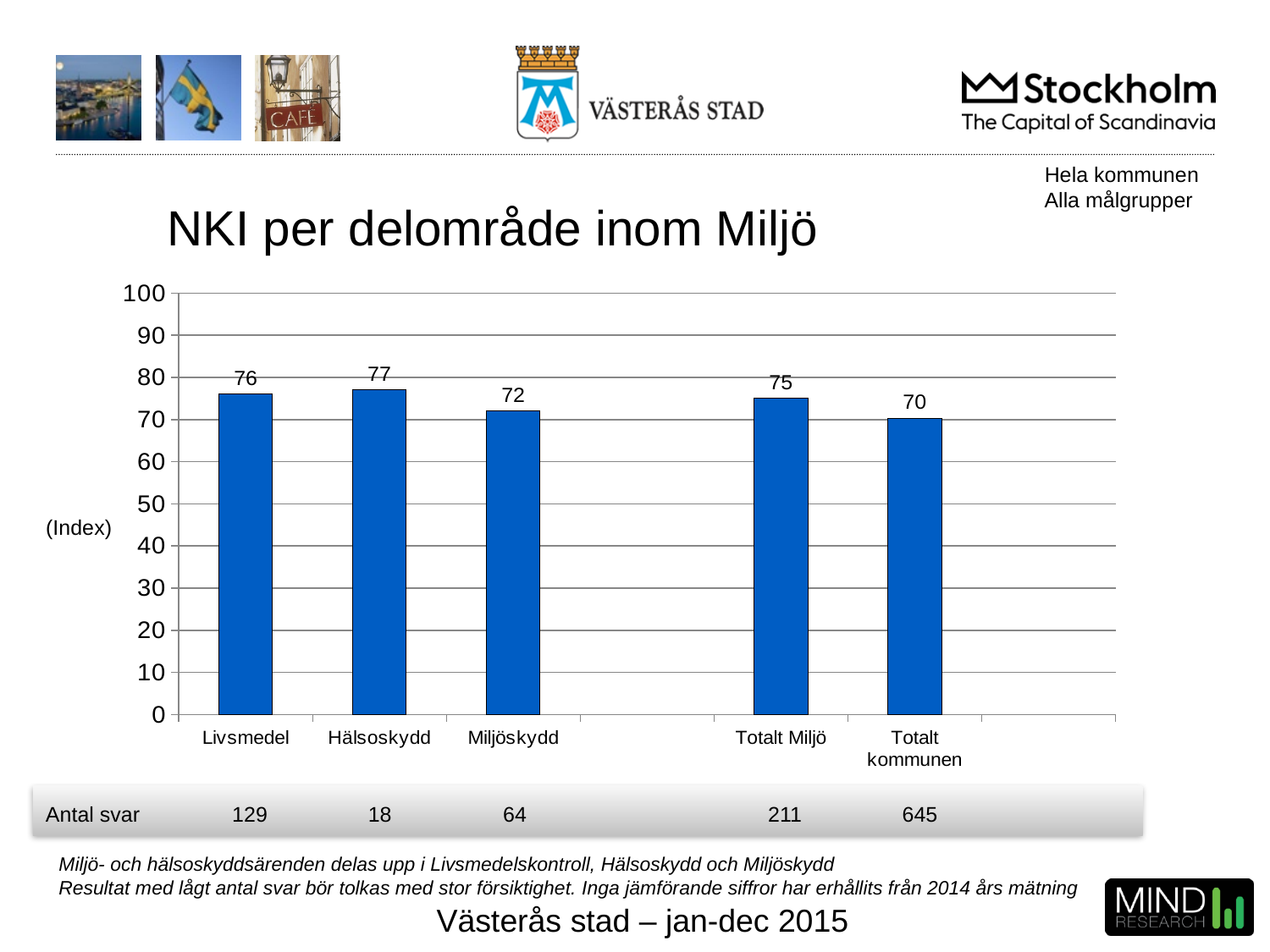
How many bars are shown in the chart? 5 Is the value for Miljöskydd greater or less than 80? less Which category has the highest NKI value? Hälsoskydd What is the NKI value for Hälsoskydd? 77 What is the NKI value for Miljöskydd? 72 Which category has the lowest NKI value? Totalt kommunen What is the title of the chart? NKI per delområde inom Miljö What is the NKI value for Livsmedel? 76 What is the difference between the NKI values for Totalt Miljö and Totalt kommunen? 5 Which has a higher NKI value, Livsmedel or Miljöskydd? Livsmedel What is the NKI value for Totalt kommunen? 70 What kind of chart is shown on the slide? Bar chart